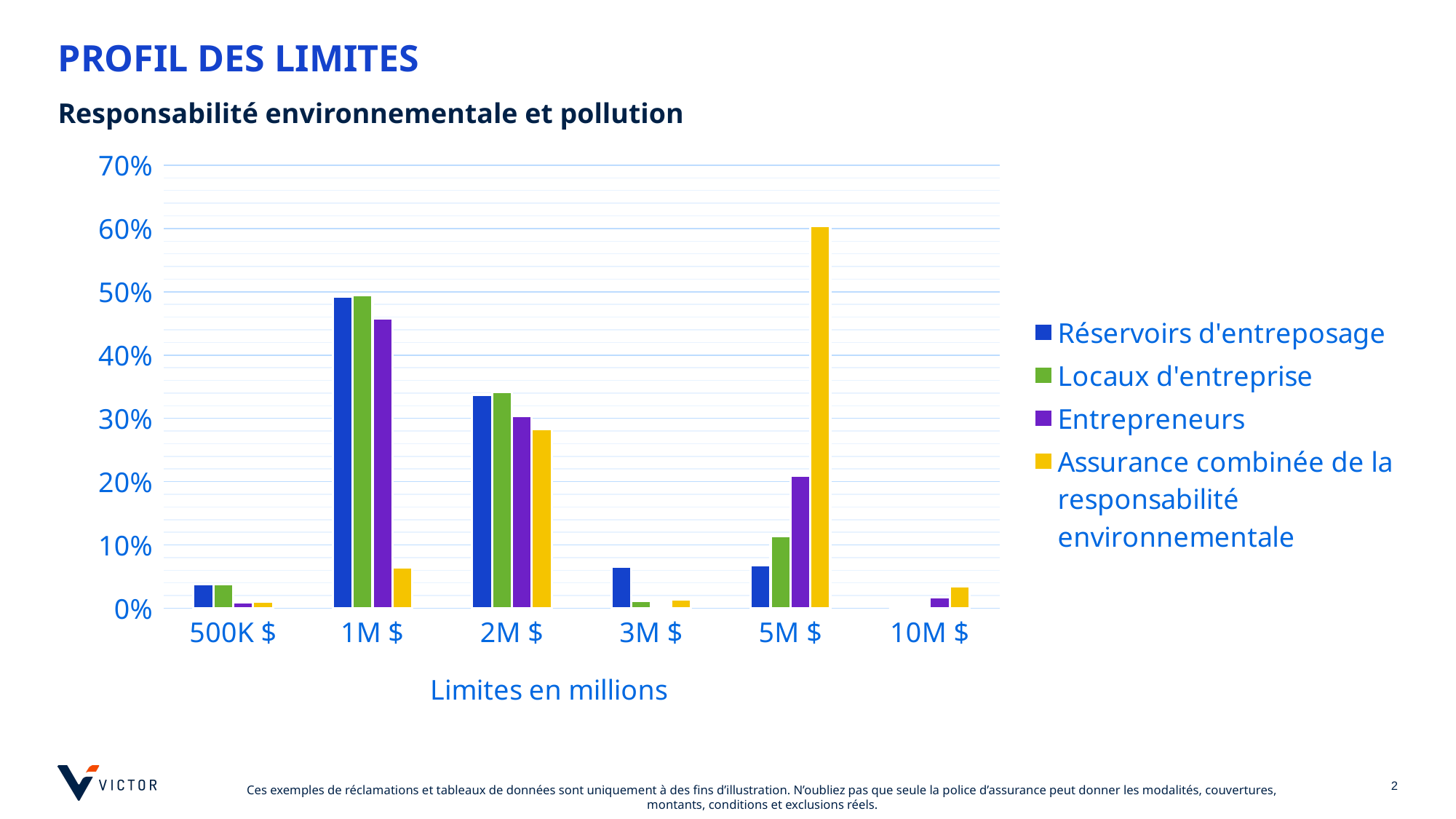
At 5M $, which is larger: Entrepreneurs or Locaux d'entreprise? Entrepreneurs How many limit categories are shown on the x axis? 6 What is the title of the x axis? Limites en millions For which limit is the value for Réservoirs d'entreposage highest? 1M $ How many series does the legend list? 4 Is the value for Réservoirs d'entreposage at 1M $ greater or less than 40%? greater For which limit is the value for Assurance combinée de la responsabilité environnementale highest? 5M $ Is the value for Locaux d'entreprise at 2M $ greater or less than 30%? greater Is the value for Entrepreneurs at 5M $ greater or less than 30%? less What kind of chart is shown on the slide? bar chart At 2M $, which is larger: Réservoirs d'entreposage or Assurance combinée de la responsabilité environnementale? Réservoirs d'entreposage